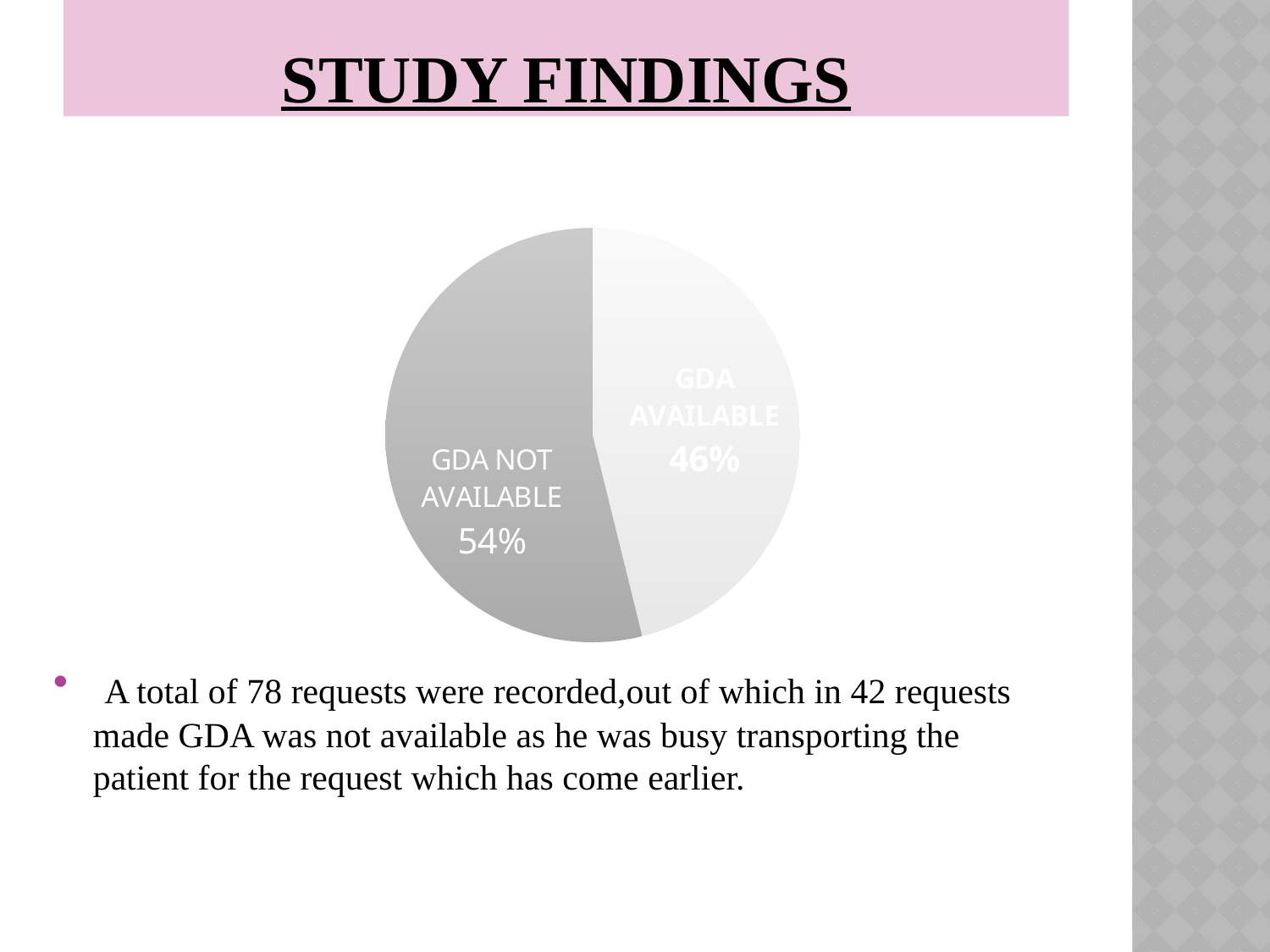
How many slices does the pie chart have? 2 What is the title of the slide containing the pie chart? STUDY FINDINGS What kind of chart is shown on the slide? Pie chart Which slice of the pie is the largest? GDA NOT AVAILABLE Which is larger, the GDA AVAILABLE slice or the GDA NOT AVAILABLE slice? GDA NOT AVAILABLE Which slice of the pie is shaded in the darker grey? GDA NOT AVAILABLE Which slice of the pie is the smallest? GDA AVAILABLE What share of the pie is labelled GDA NOT AVAILABLE? 54% What is the difference in percentage points between the GDA NOT AVAILABLE and GDA AVAILABLE slices? 8 What share of the pie is labelled GDA AVAILABLE? 46% Is the share for GDA AVAILABLE greater or less than 50%? less